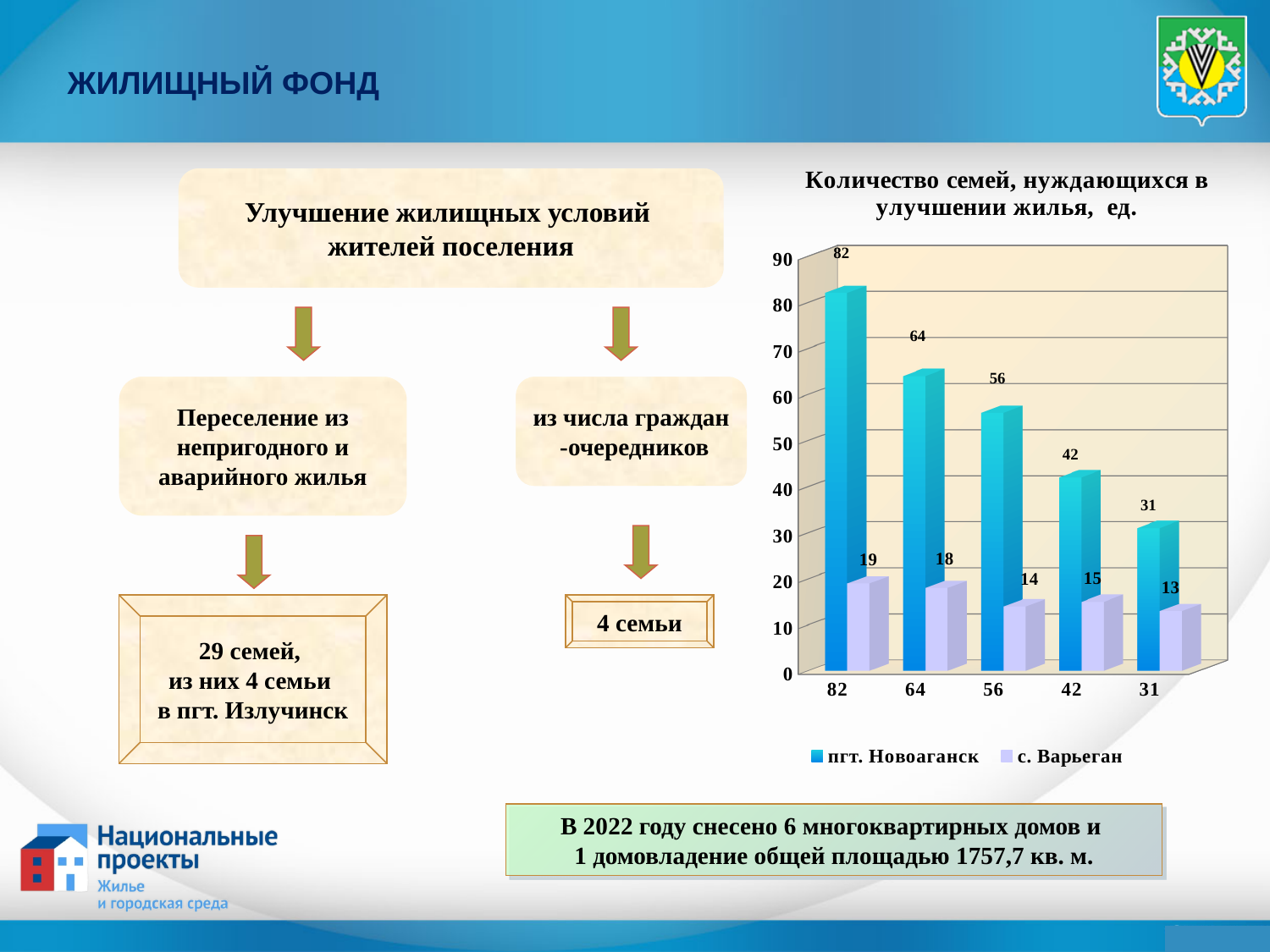
What type of chart is shown on the slide? bar chart Which category has the lowest value for с. Варьеган? 31 (the last category) In the fourth category, which series has the larger value: пгт. Новоаганск or с. Варьеган? пгт. Новоаганск What is the value for с. Варьеган in the last (rightmost) category of the chart? 13 Do the values for пгт. Новоаганск rise or fall from left to right along the x axis? fall Which category has the highest value for пгт. Новоаганск? 82 (the first category) How many categories are shown along the x axis of the chart? 5 What is the value for с. Варьеган in the first (leftmost) category of the chart? 19 What is the difference between пгт. Новоаганск and с. Варьеган in the first category of the chart? 63 What is the title of the chart on the slide? Количество семей, нуждающихся в улучшении жилья, ед. What is the value for пгт. Новоаганск in the third category of the chart? 56 How many series does the chart legend list? 2